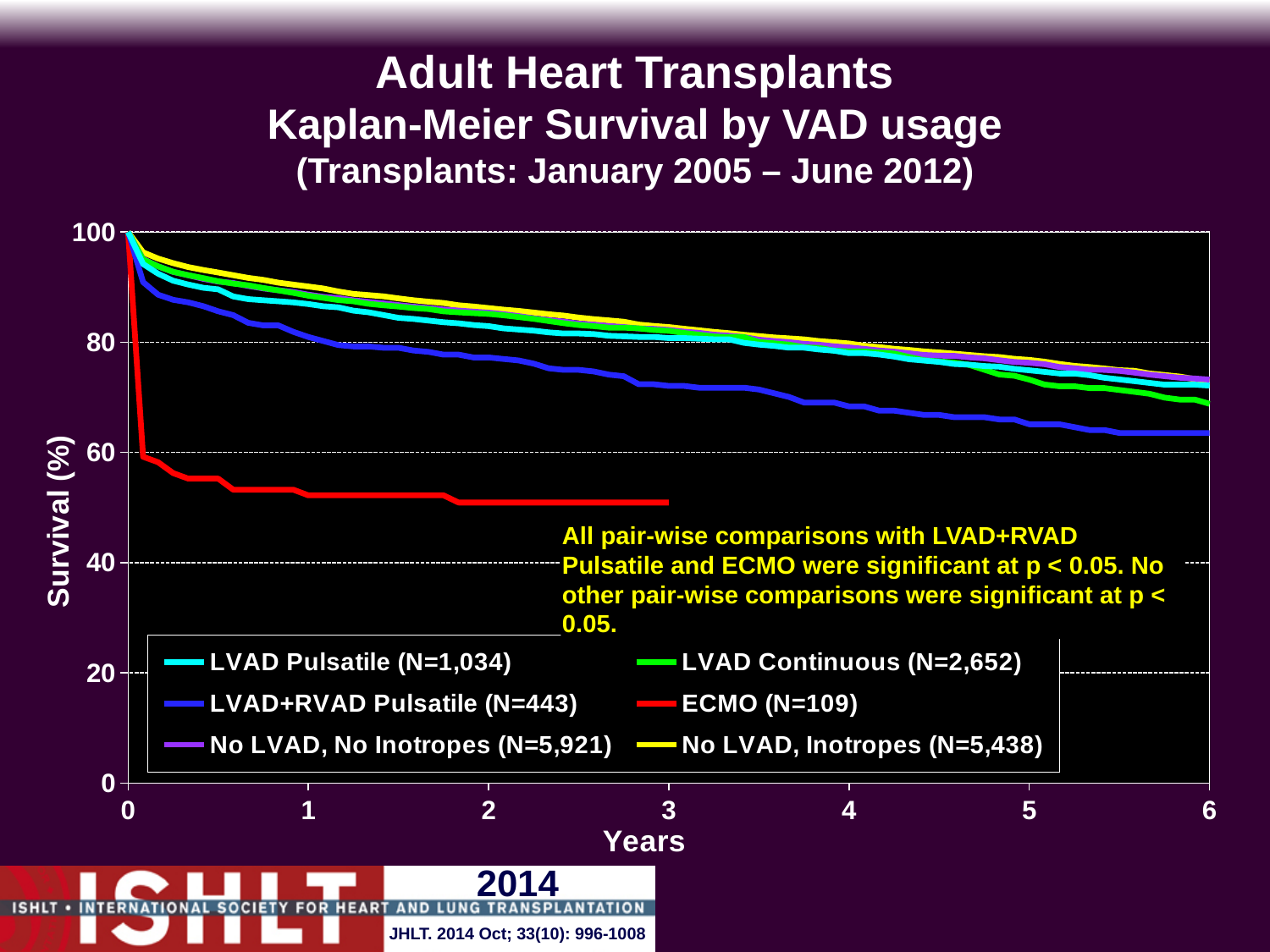
Is the survival value for LVAD+RVAD Pulsatile at 6 years greater or less than 60? greater What colour is the line for LVAD Continuous? green How many series does the legend list? 6 What kind of chart is shown on the slide? line chart Do the survival curves rise or fall as years increase? fall Is the survival value for No LVAD, Inotropes at 1 year greater or less than 80? greater Which series has the lowest survival throughout the chart? ECMO Which is larger at 3 years: the survival for ECMO or for LVAD+RVAD Pulsatile? LVAD+RVAD Pulsatile Is the survival value for ECMO at 3 years greater or less than 60? less What is the N shown in the legend for ECMO? N=109 Which is larger at 6 years: the survival for LVAD Continuous or for LVAD+RVAD Pulsatile? LVAD Continuous